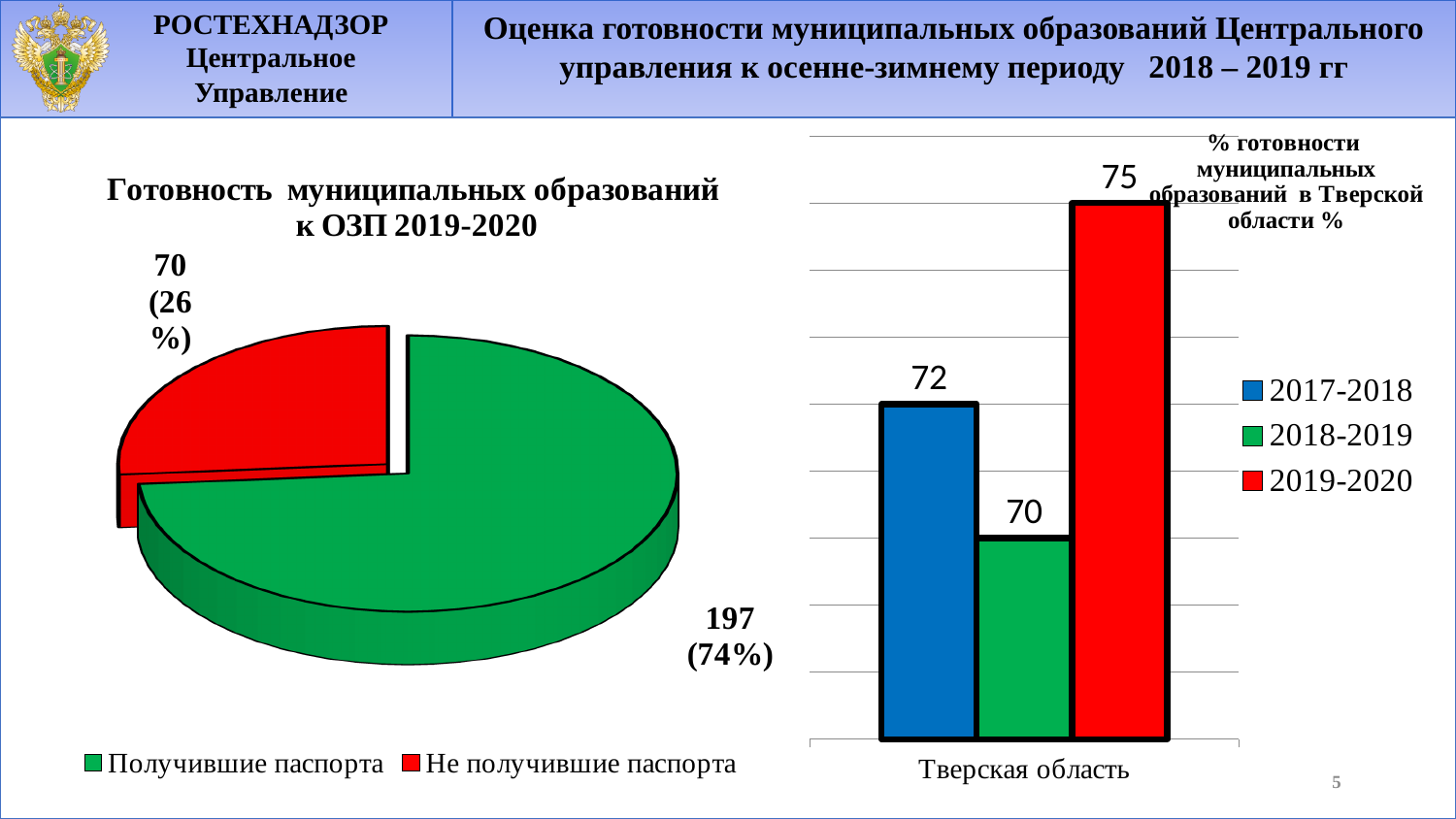
In the pie chart on the left, how many slices does the pie have? 2 In the bar chart on the right, what is the difference between the 2019-2020 value and the 2017-2018 value? 3 In the pie chart on the left, what is the difference between the number of municipalities that received passports and those that did not? 127 In the pie chart on the left, how many municipalities are in the 'Получившие паспорта' slice? 197 In the pie chart on the left, what share of the pie does the 'Получившие паспорта' slice represent? 74% In the bar chart on the right, which series has the highest value? 2019-2020 In the bar chart on the right, what is the value for the 2019-2020 series? 75 In the pie chart on the left, which slice is larger: 'Получившие паспорта' or 'Не получившие паспорта'? Получившие паспорта In the bar chart on the right, what is the value for the 2018-2019 series? 70 In the bar chart on the right, how many series does the legend list? 3 In the pie chart on the left, what share of the pie does the 'Не получившие паспорта' slice represent? 26% In the bar chart on the right, which series has the lowest value? 2018-2019